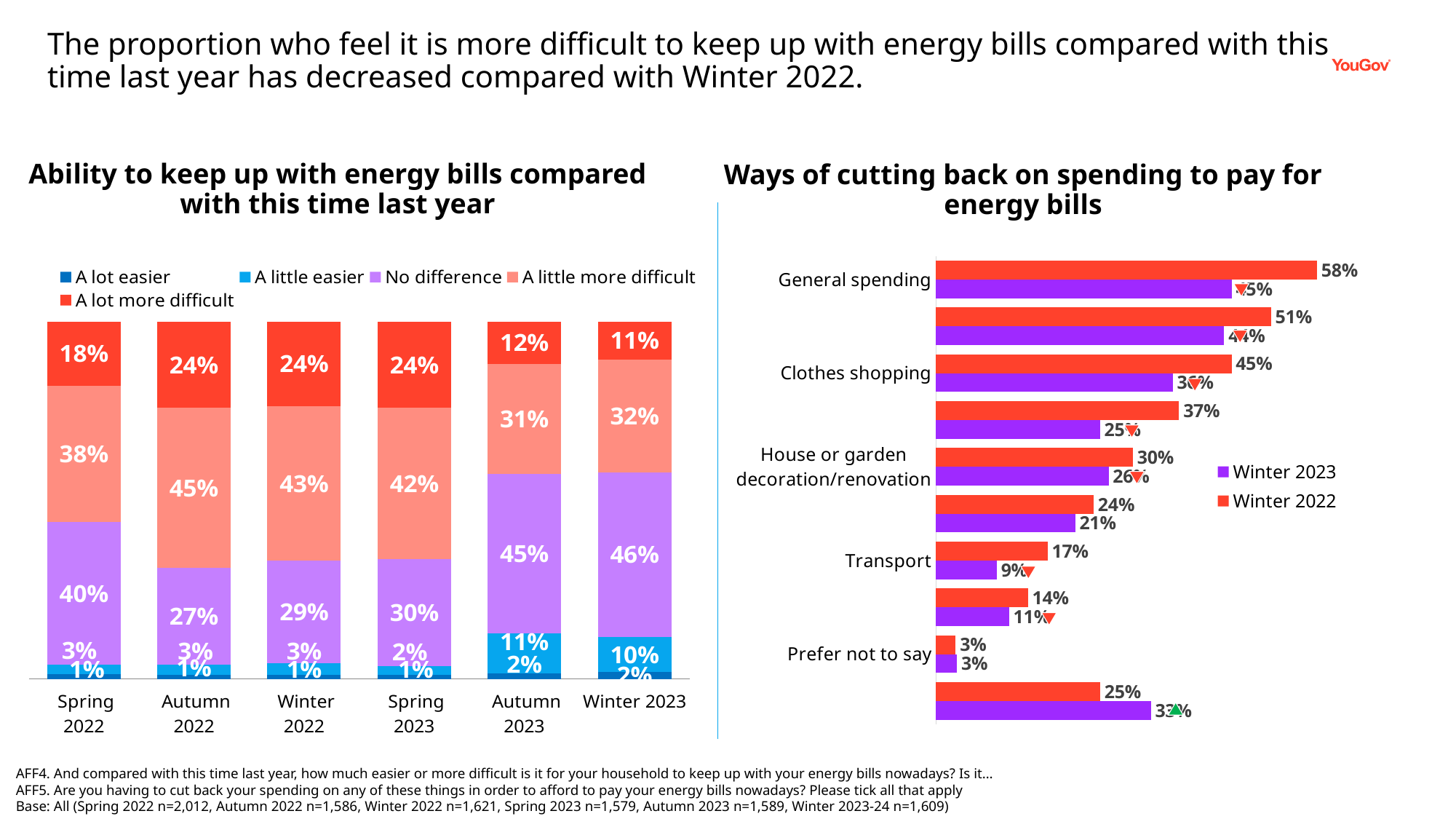
In the 'Ability to keep up with energy bills compared with this time last year' chart, what percentage said 'A lot more difficult' in Spring 2022? 18% In the 'Ways of cutting back on spending to pay for energy bills' chart, what is the Winter 2023 value for Transport? 9% In the 'Ability to keep up with energy bills compared with this time last year' chart, how many time periods are shown on the x axis? 6 In the 'Ways of cutting back on spending to pay for energy bills' chart, what is the difference between the Winter 2022 and Winter 2023 values for House or garden decoration/renovation? 4% In the 'Ability to keep up with energy bills compared with this time last year' chart, what is the difference between the 'No difference' values for Autumn 2022 and Autumn 2023? 18% In the 'Ways of cutting back on spending to pay for energy bills' chart, which is larger for Transport: the Winter 2022 value or the Winter 2023 value? Winter 2022 In the 'Ability to keep up with energy bills compared with this time last year' chart, how many series does the legend list? 5 In the 'Ability to keep up with energy bills compared with this time last year' chart, what percentage said 'No difference' in Winter 2023? 46% In the 'Ability to keep up with energy bills compared with this time last year' chart, what percentage said 'A little more difficult' in Autumn 2022? 45% In the 'Ability to keep up with energy bills compared with this time last year' chart, which period has the lowest 'A lot more difficult' value? Winter 2023 What kind of chart is 'Ways of cutting back on spending to pay for energy bills'? Bar chart In the 'Ways of cutting back on spending to pay for energy bills' chart, what is the Winter 2022 value for General spending? 58%